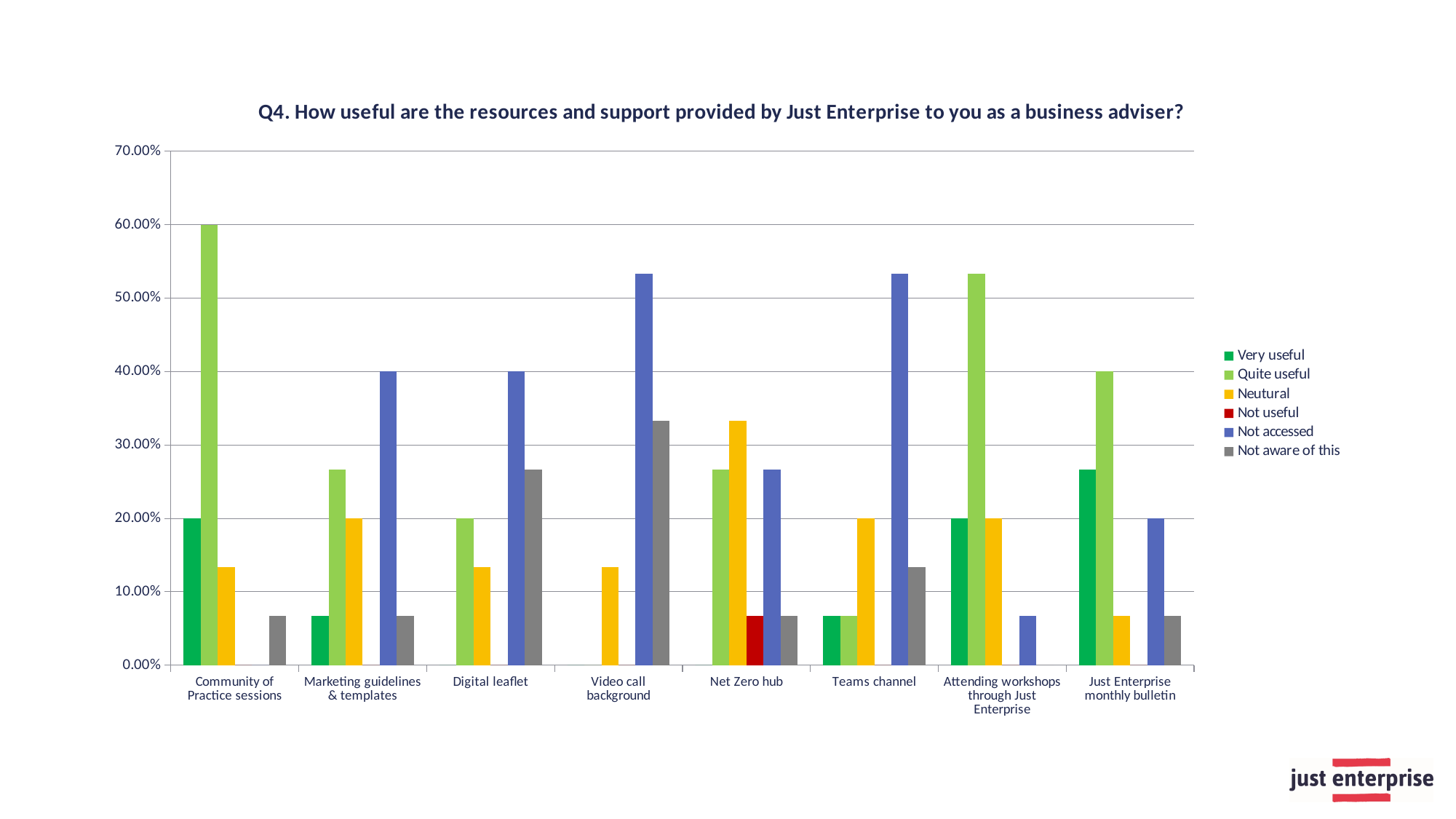
How many series does the legend list? 6 What is the 'Very useful' value for Attending workshops through Just Enterprise? 20.00% What is the 'Quite useful' value for Just Enterprise monthly bulletin? 40.00% Which category is the only one with a 'Not useful' bar? Net Zero hub What type of chart is shown on the slide? bar chart How many resource categories are shown on the x axis? 8 Is the 'Neutural' value for Net Zero hub greater or less than 30.00%? greater What is the 'Quite useful' value for Community of Practice sessions? 60.00% Which category has the highest 'Quite useful' value? Community of Practice sessions Is the 'Not accessed' value for Video call background greater or less than 50.00%? greater What is the 'Not accessed' value for Digital leaflet? 40.00% Which is larger: the 'Very useful' value for Just Enterprise monthly bulletin or the 'Very useful' value for Teams channel? Just Enterprise monthly bulletin